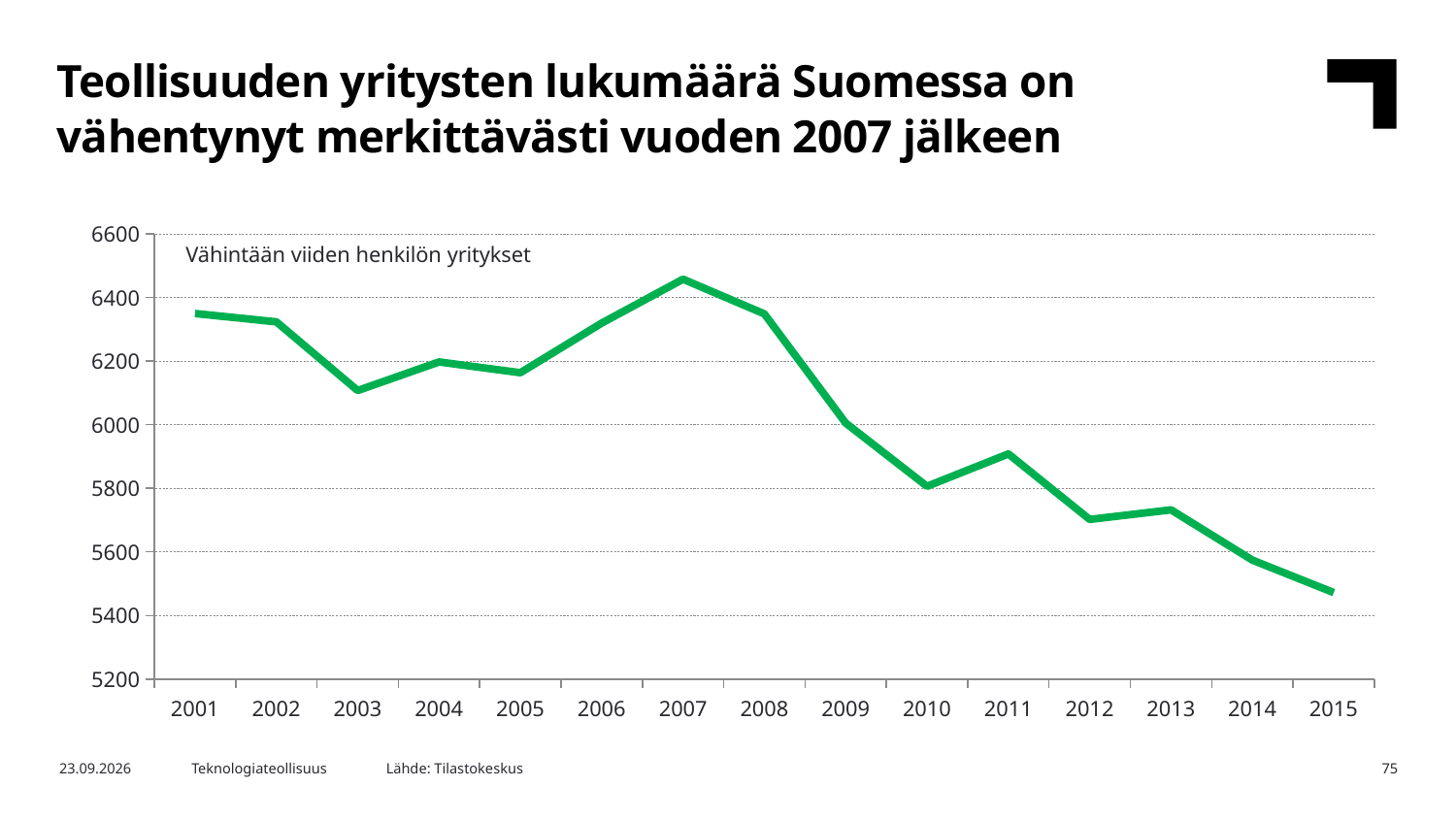
In which year is the number of industrial companies lowest? 2015 Which year has the larger value, 2001 or 2012? 2001 Is the value for 2007 greater or less than 6400? greater What source is cited for the chart data? Tilastokeskus What kind of chart is shown on the slide? Line chart What text annotation appears inside the chart area? Vähintään viiden henkilön yritykset Do the values rise or fall from 2007 to 2015? Fall Is the value for 2015 greater or less than 5600? less How many years are plotted on the x axis? 15 Is the value for 2003 greater or less than 6200? less In which year is the number of industrial companies highest? 2007